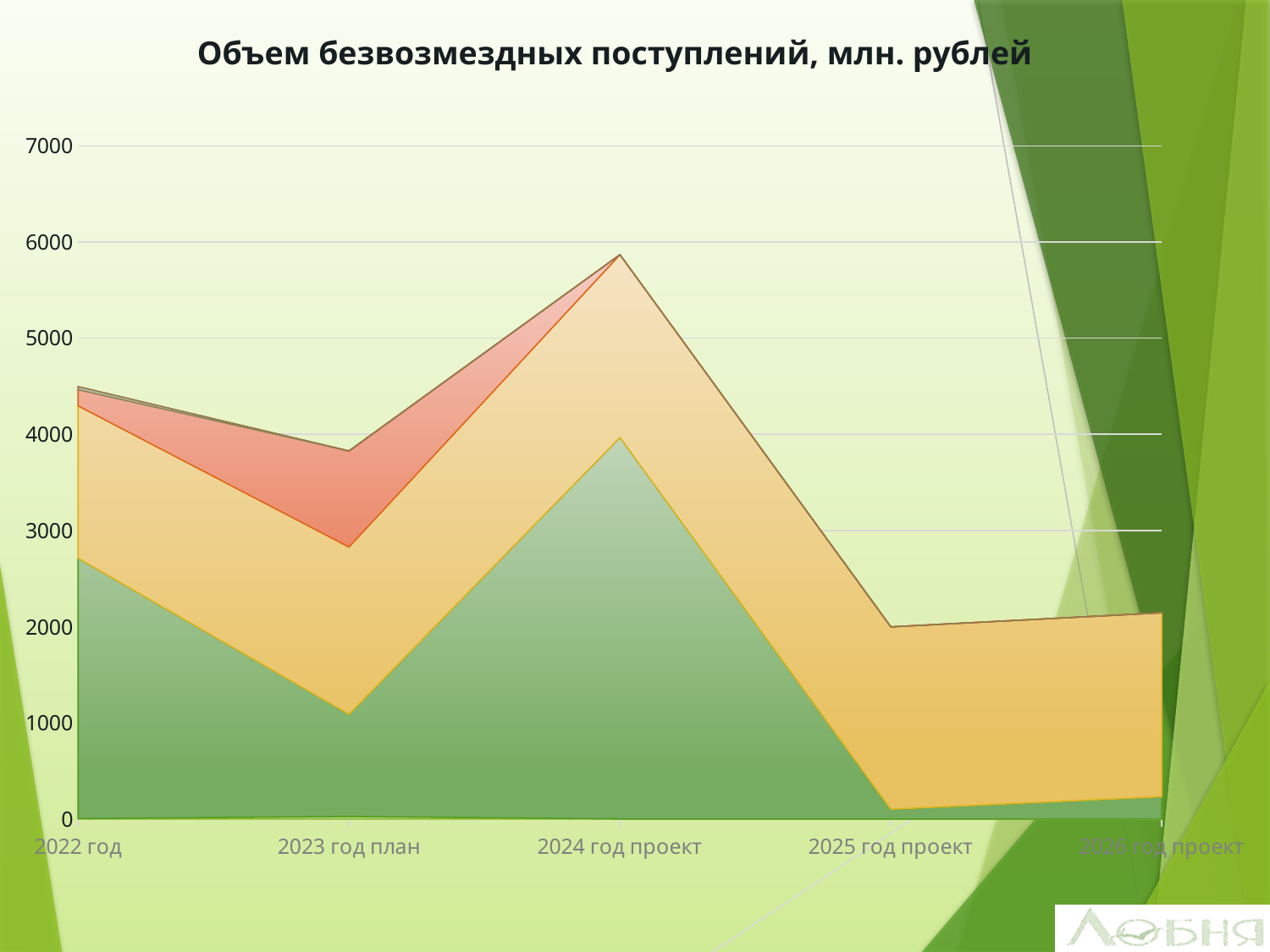
In which year is the total stacked value the highest? 2024 год проект Does the total stacked value rise or fall from 2024 год проект to 2025 год проект? fall Which has the larger total stacked value, 2022 год or 2023 год план? 2022 год Is the total stacked value for 2025 год проект greater or less than 3000? less Is the value of the bottom (green) area for 2022 год greater or less than 3000? less Is the total stacked value for 2024 год проект greater or less than 5000? greater What is the title of the chart? Объем безвозмездных поступлений, млн. рублей What kind of chart is shown on the slide? Stacked area chart In which year does the bottom (green) area reach its highest value? 2024 год проект How many categories are shown along the x axis? 5